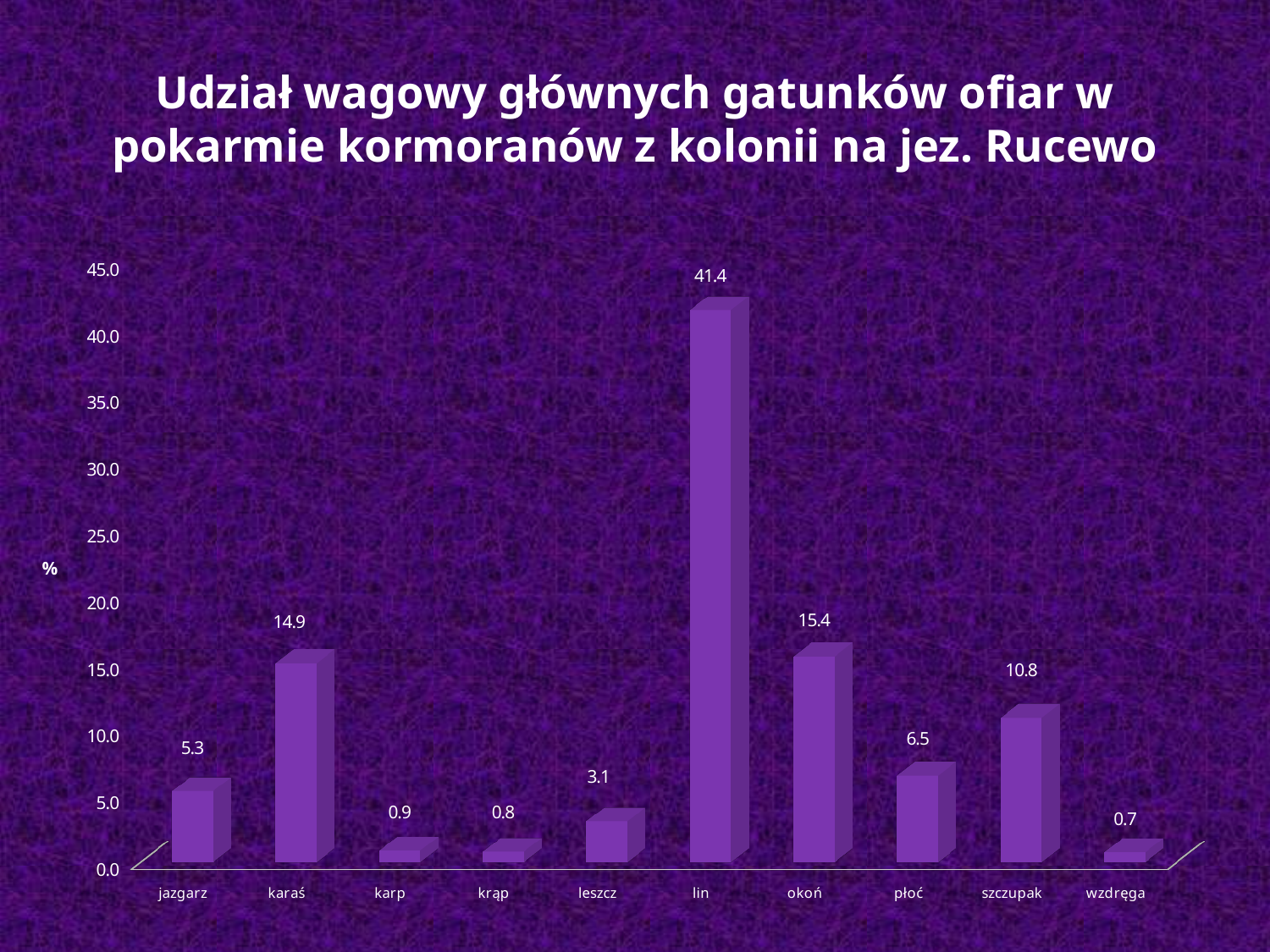
What label is shown on the vertical axis? % What kind of chart is shown on the slide? bar chart What is the value for lin? 41.4 What is the value for karaś? 14.9 Which category has the highest value? lin What is the value for szczupak? 10.8 What is the difference between the values for okoń and karaś? 0.5 Is the value for lin greater or less than 40.0? greater What is the difference between the values for lin and okoń? 26.0 How many categories are shown on the x axis? 10 Which is larger, the value for płoć or the value for jazgarz? płoć Which category has the lowest value? wzdręga